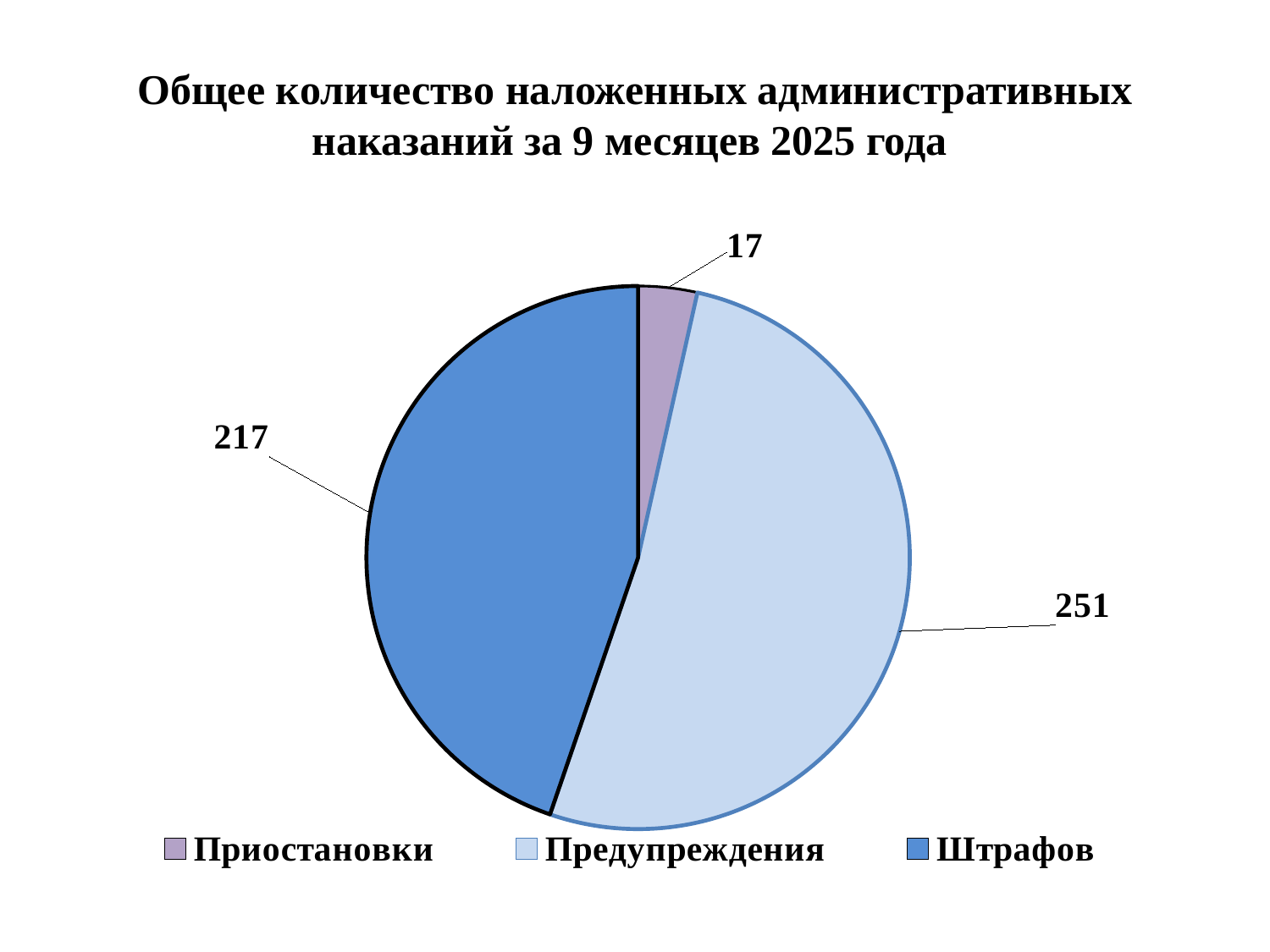
What is the value for Штрафов? 217 What is the value for Приостановки? 17 What is the difference between Штрафов and Приостановки? 200 Which is larger, Штрафов or Предупреждения? Предупреждения What type of chart is shown on the slide? pie chart How many categories does the pie chart have? 3 Which category has the largest slice? Предупреждения Which category has the smallest slice? Приостановки What is the difference between Предупреждения and Штрафов? 34 What is the total of all slices in the pie chart? 485 What is the title of the chart? Общее количество наложенных административных наказаний за 9 месяцев 2025 года What is the value for Предупреждения? 251